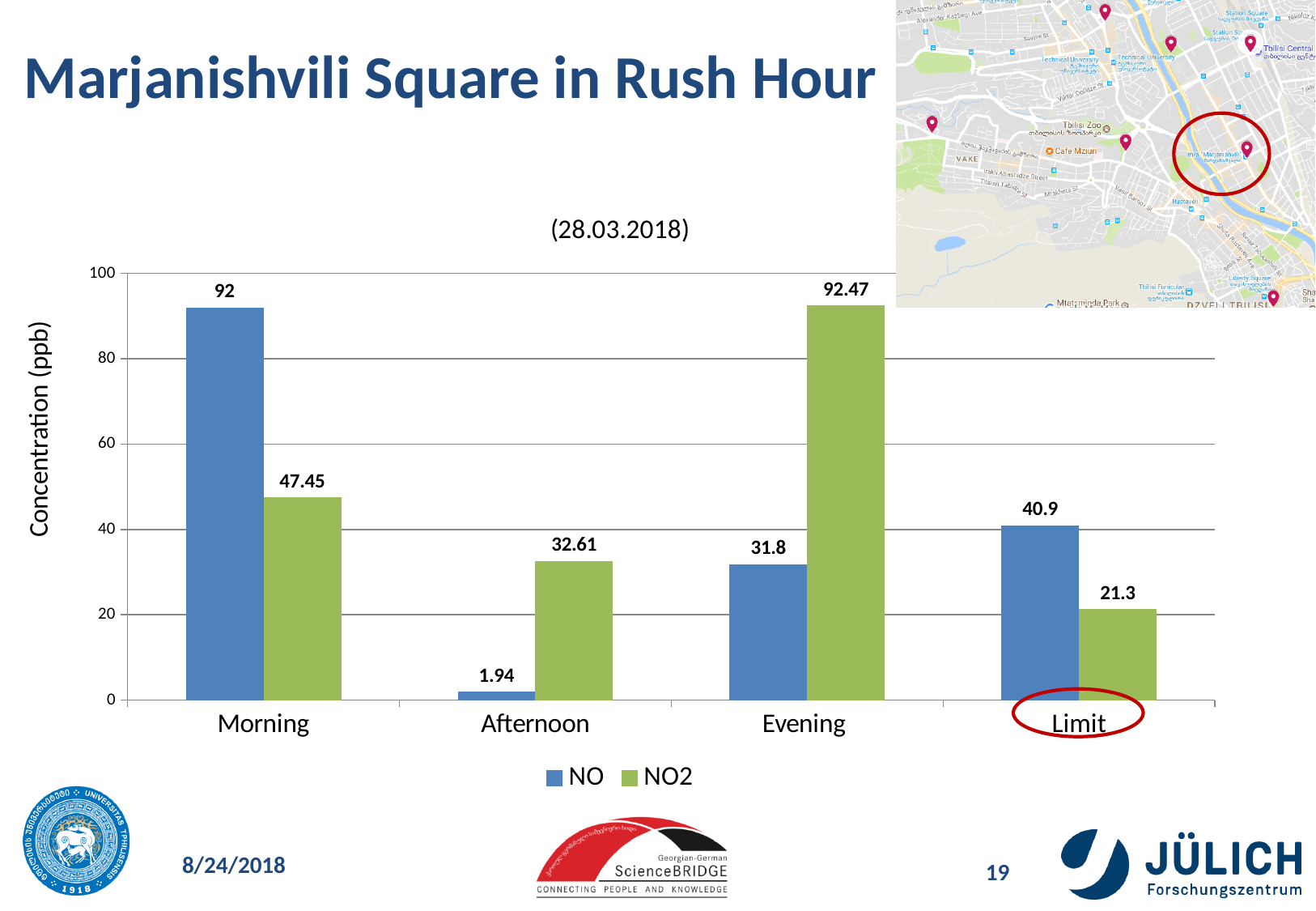
What is the label of the y axis? Concentration (ppb) What is the NO2 concentration in the Evening? 92.47 Which category has the highest NO2 concentration? Evening What is the NO value for the Limit category? 40.9 What is the difference between the NO2 values for Morning and Limit? 26.15 How many categories are shown on the x axis? 4 How many series does the legend list? 2 What kind of chart is shown on the slide? Bar chart Which is larger in the Evening, the NO value or the NO2 value? NO2 What is the NO concentration in the Morning? 92 What is the NO2 concentration in the Afternoon? 32.61 Which category has the lowest NO concentration? Afternoon